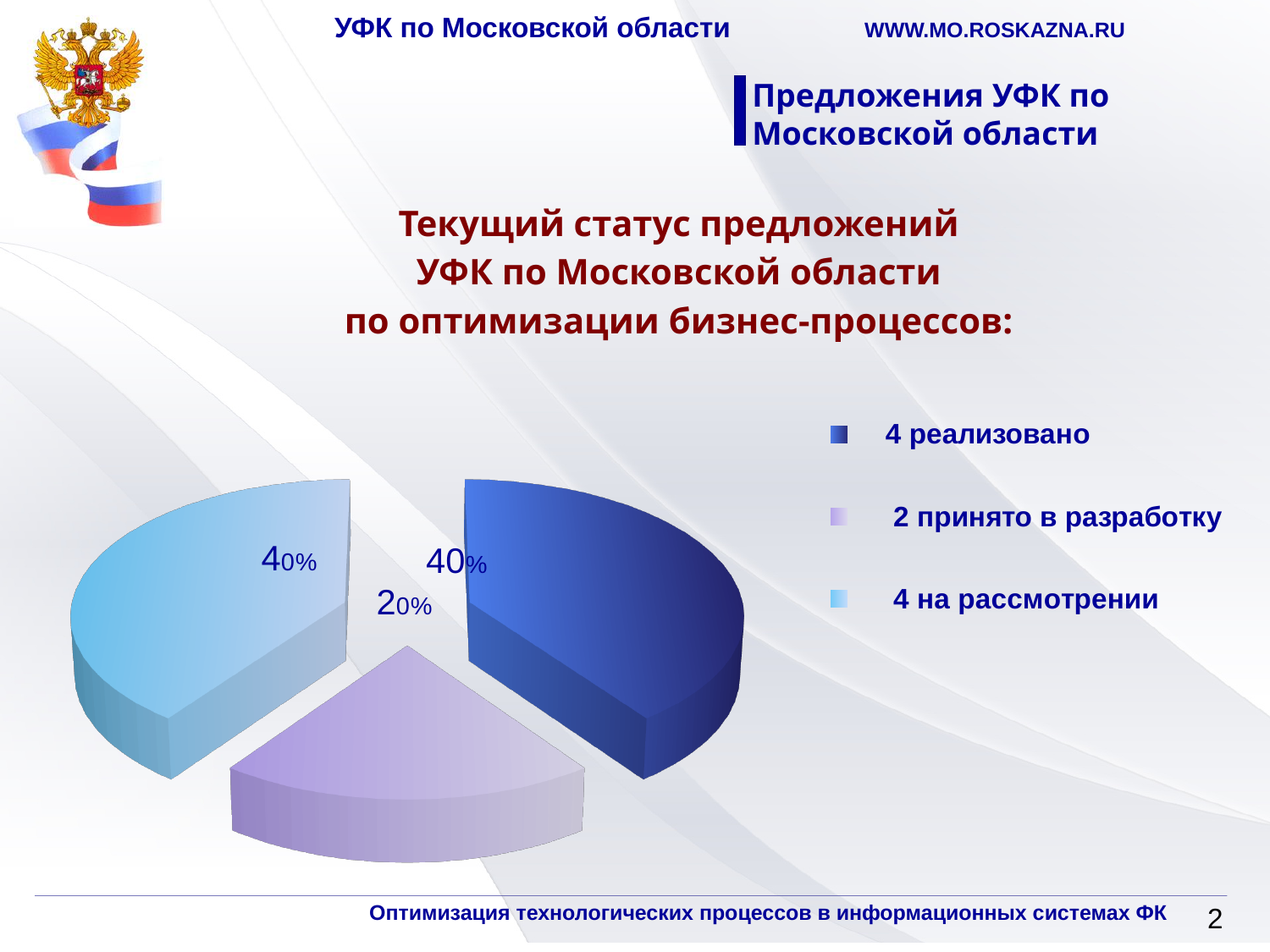
What share of the pie does the 'принято в разработку' slice represent? 20% Which slice of the pie chart is the smallest? принято в разработку What is the difference in percentage points between the 'на рассмотрении' slice and the 'принято в разработку' slice? 20 How many proposals does the legend say are 'на рассмотрении'? 4 How many entries does the legend of the pie chart list? 3 What kind of chart is shown on the slide? pie chart What percentage is shown for the 'принято в разработку' slice of the pie chart? 20% What percentage is shown for the 'реализовано' slice of the pie chart? 40% What colour is the 'реализовано' slice in the pie chart? dark blue What percentage is shown for the 'на рассмотрении' slice of the pie chart? 40% How many slices does the pie chart have? 3 Which is larger in the pie chart: the 'реализовано' slice or the 'принято в разработку' slice? реализовано